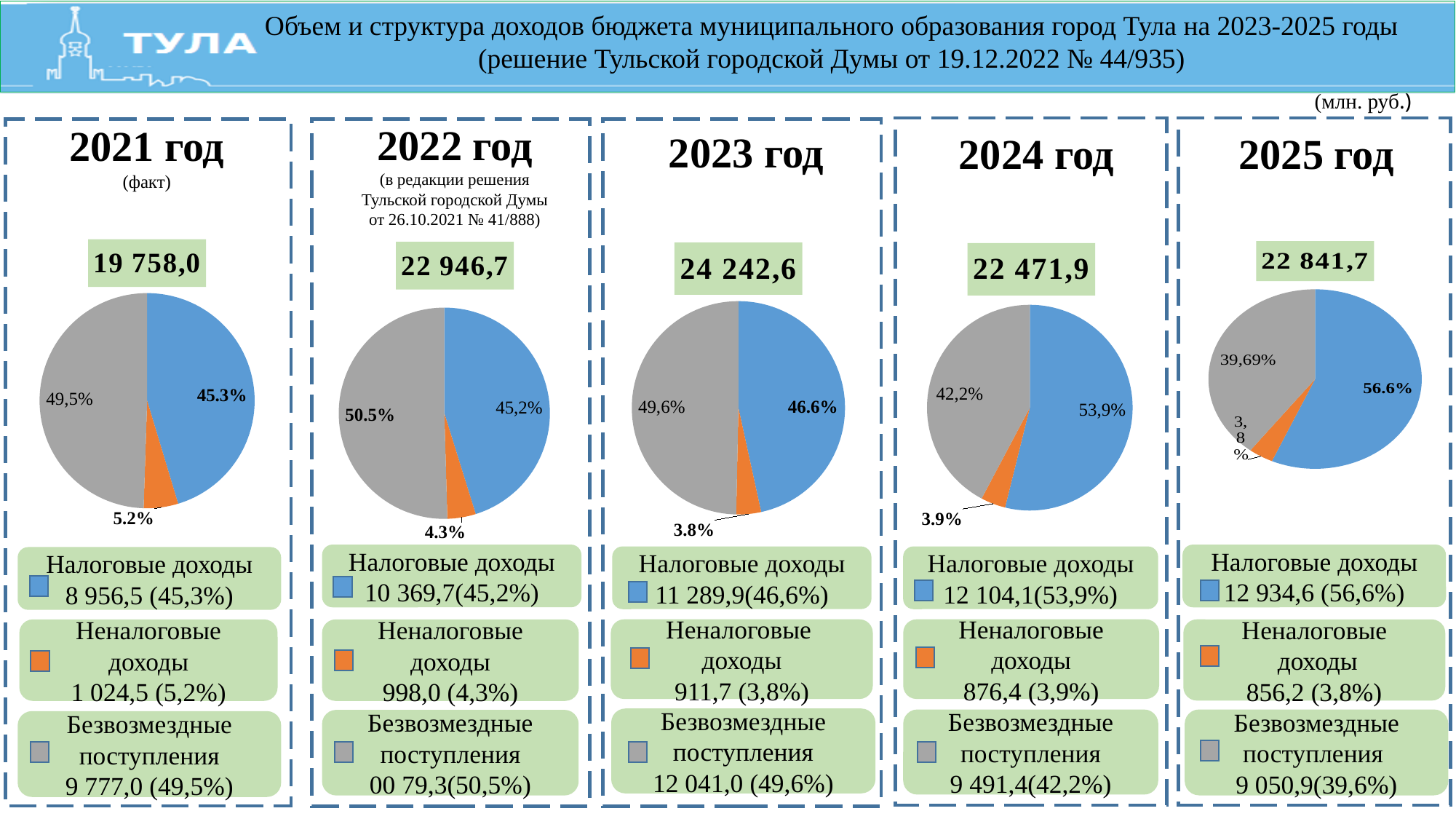
In the 2024 год chart, what is the difference in percentage points between the Налоговые доходы share (53,9%) and the Безвозмездные поступления share (42,2%)? 11,7 In the 2024 год chart, which slice is larger: Налоговые доходы or Безвозмездные поступления? Налоговые доходы In the 2024 год pie chart, what share is labelled for the orange slice (Неналоговые доходы)? 3.9% What kind of chart is used for each year on the slide? Pie chart According to the legend of the 2025 год chart, what is the value of Неналоговые доходы? 856,2 (3,8%) In the 2021 год pie chart, what share is labelled for the blue slice (Налоговые доходы)? 45.3% In the 2022 год chart, which category has the smallest slice? Неналоговые доходы In the 2023 год chart, which category has the largest slice? Безвозмездные поступления What total value is shown above the 2023 год pie chart? 24 242,6 How many slices does the 2023 год pie chart have? 3 Which colour represents Безвозмездные поступления in the pie charts? Grey In the 2025 год pie chart, what share is labelled for the blue slice (Налоговые доходы)? 56.6%